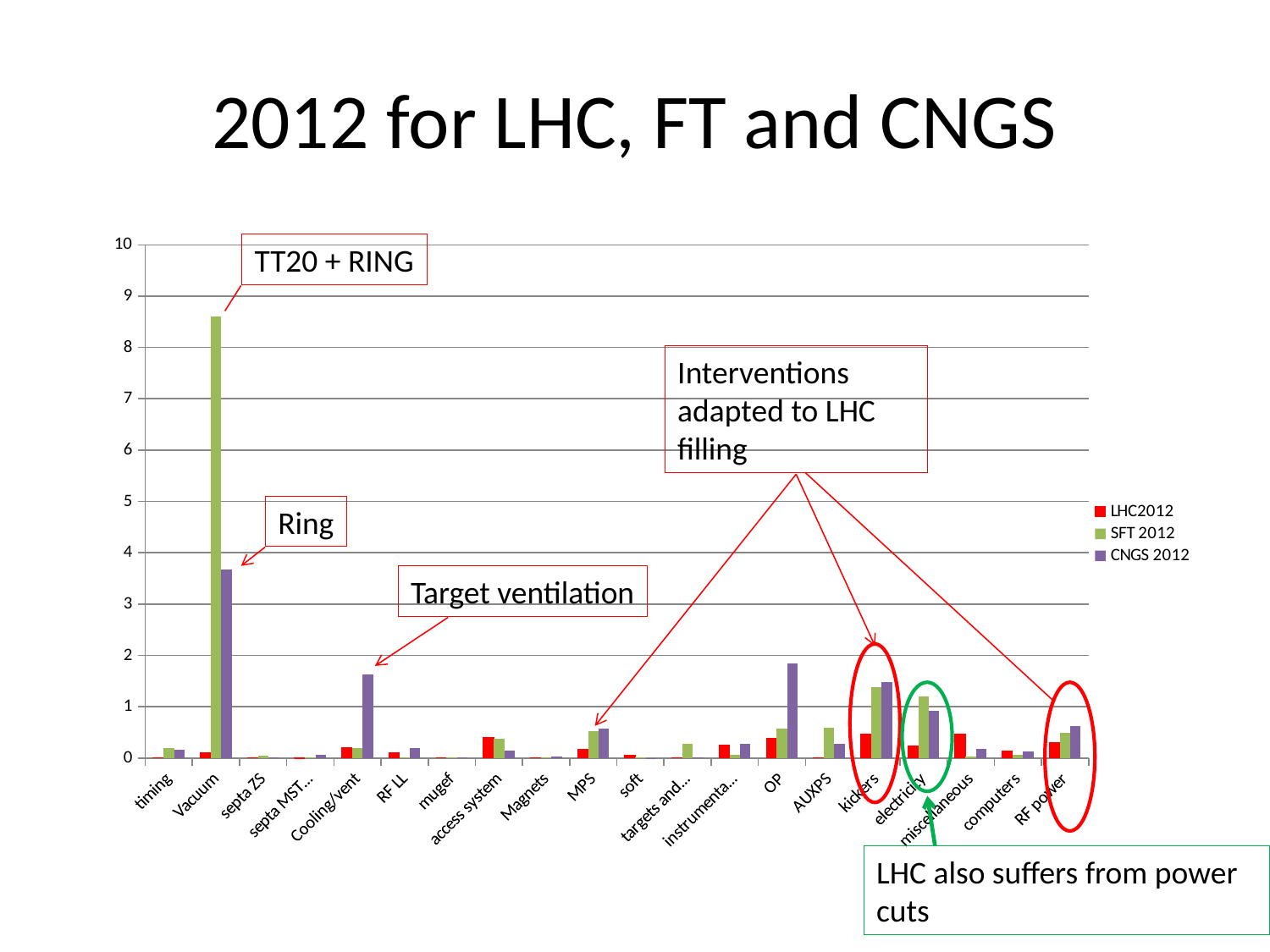
Which category has the highest SFT 2012 value? Vacuum What is the title of the slide containing the chart? 2012 for LHC, FT and CNGS Which category has the highest CNGS 2012 value? Vacuum How many series does the legend list? 3 For Vacuum, which is larger: the SFT 2012 value or the CNGS 2012 value? SFT 2012 Is the CNGS 2012 value for Cooling/vent greater or less than 1? greater What kind of chart is shown on the slide? bar chart Which colour represents the LHC2012 series in the legend? red Is the CNGS 2012 value for Vacuum greater or less than 3? greater How many categories are shown along the x axis? 20 Is the CNGS 2012 value for OP greater or less than 2? less